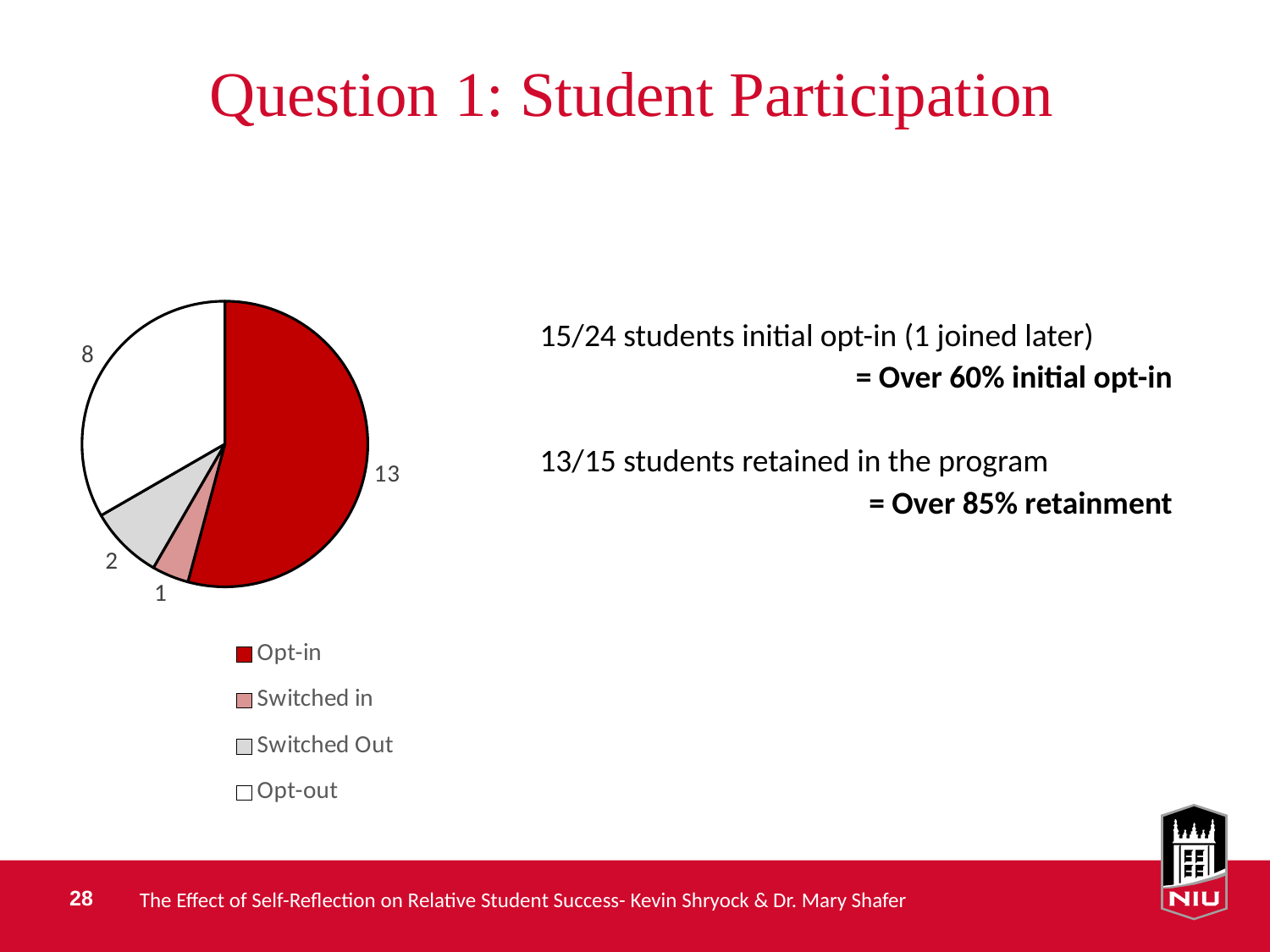
What is the total of all slices in the pie chart? 24 What is the difference between the Opt-in and Opt-out values? 5 What kind of chart is shown on the slide? pie chart What is the value for Opt-in in the pie chart? 13 Which is larger, Switched Out or Switched in? Switched Out Which category has the smallest slice in the pie chart? Switched in How many categories does the pie chart have? 4 Which colour represents Opt-in in the legend? red Which category has the largest slice in the pie chart? Opt-in What is the value for Opt-out in the pie chart? 8 What is the value for Switched Out in the pie chart? 2 What is the value for Switched in in the pie chart? 1